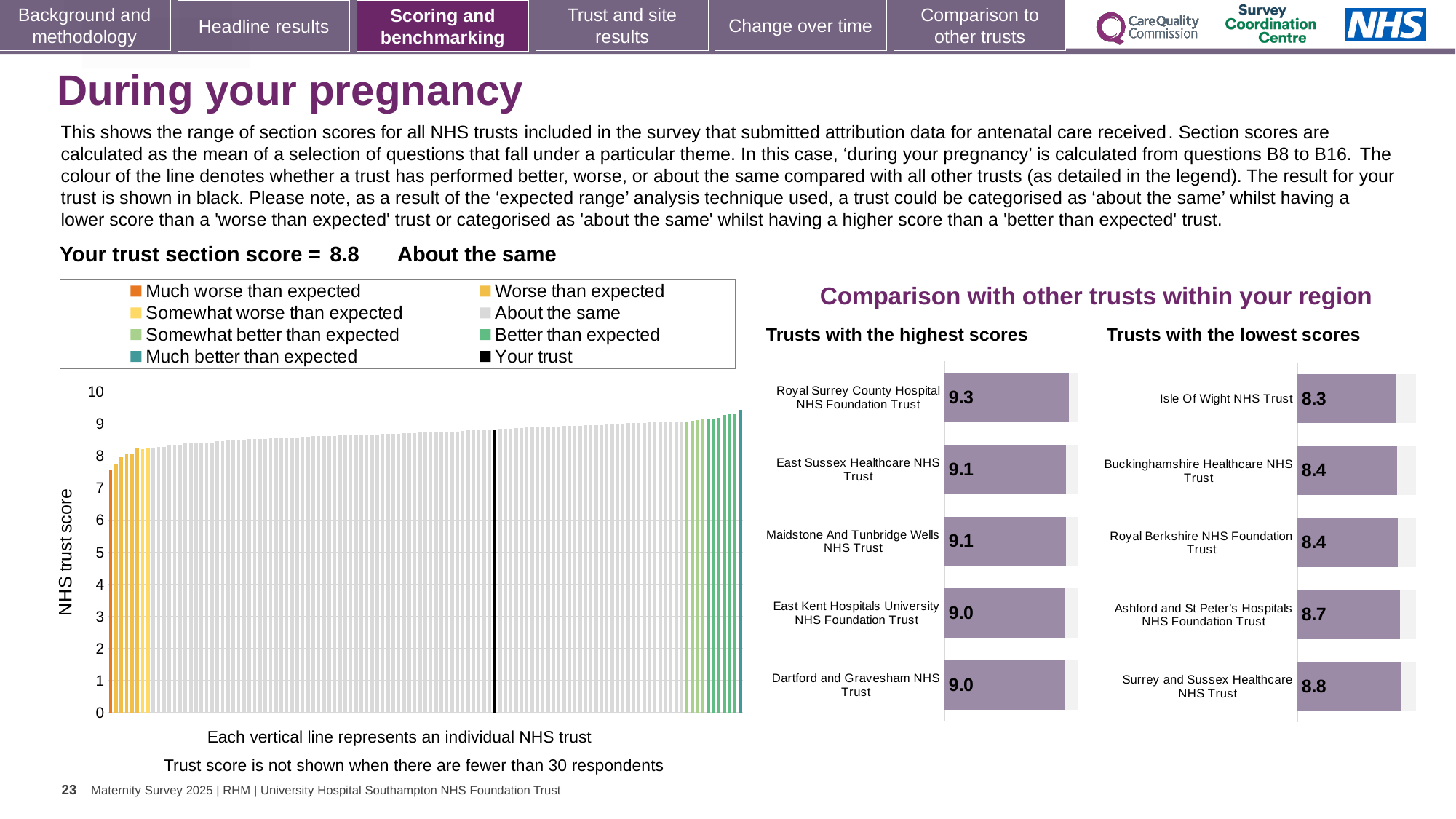
What is the label on the vertical axis of the main chart on the left? NHS trust score In the 'Trusts with the lowest scores' chart, what is the difference between the scores of Surrey and Sussex Healthcare NHS Trust and Isle Of Wight NHS Trust? 0.5 In the 'Trusts with the lowest scores' chart, which has the higher score: Ashford and St Peter's Hospitals NHS Foundation Trust or Buckinghamshire Healthcare NHS Trust? Ashford and St Peter's Hospitals NHS Foundation Trust In the 'Trusts with the highest scores' chart, what is the score for Royal Surrey County Hospital NHS Foundation Trust? 9.3 In the 'Trusts with the lowest scores' chart, what is the score for Isle Of Wight NHS Trust? 8.3 What kind of chart is the 'Trusts with the lowest scores' chart? Bar chart In the 'Trusts with the highest scores' chart, which trust has the highest score? Royal Surrey County Hospital NHS Foundation Trust In the 'Trusts with the lowest scores' chart, which trust has the lowest score? Isle Of Wight NHS Trust In the 'Trusts with the highest scores' chart, what is the difference between the scores of Royal Surrey County Hospital NHS Foundation Trust and Dartford and Gravesham NHS Trust? 0.3 How many trusts are shown in the 'Trusts with the highest scores' chart? 5 How many entries does the legend of the main NHS trust score chart list? 8 In the main NHS trust score chart, is the value of the leftmost (orange) bar greater or less than 8? less